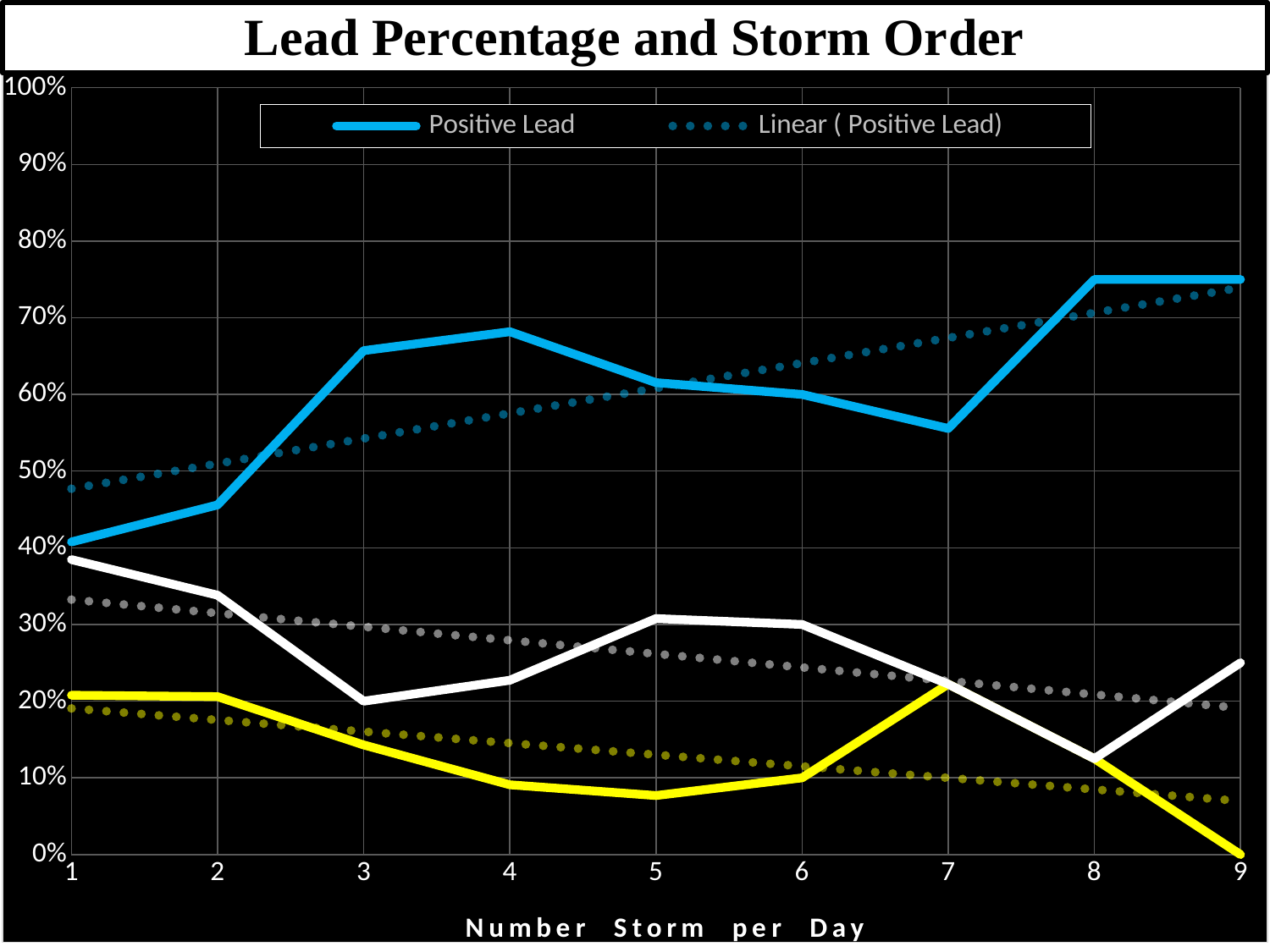
Is the Positive Lead value at 7 storms per day greater or less than 60%? less What is the title of the x axis? Number Storm per Day Which has the larger Positive Lead value: 4 storms per day or 5 storms per day? 4 storms per day At which number of storms per day is the Positive Lead value lowest? 1 Does the Linear ( Positive Lead) trendline rise or fall from left to right? rise Is the Positive Lead value at 8 storms per day greater or less than 70%? greater Is the Positive Lead value at 2 storms per day greater or less than 50%? less How many series does the legend list? 2 How many storm-number categories are shown along the x axis? 9 Does the Positive Lead line rise or fall from 1 to 4 storms per day? rise What kind of chart is shown on the slide? line chart